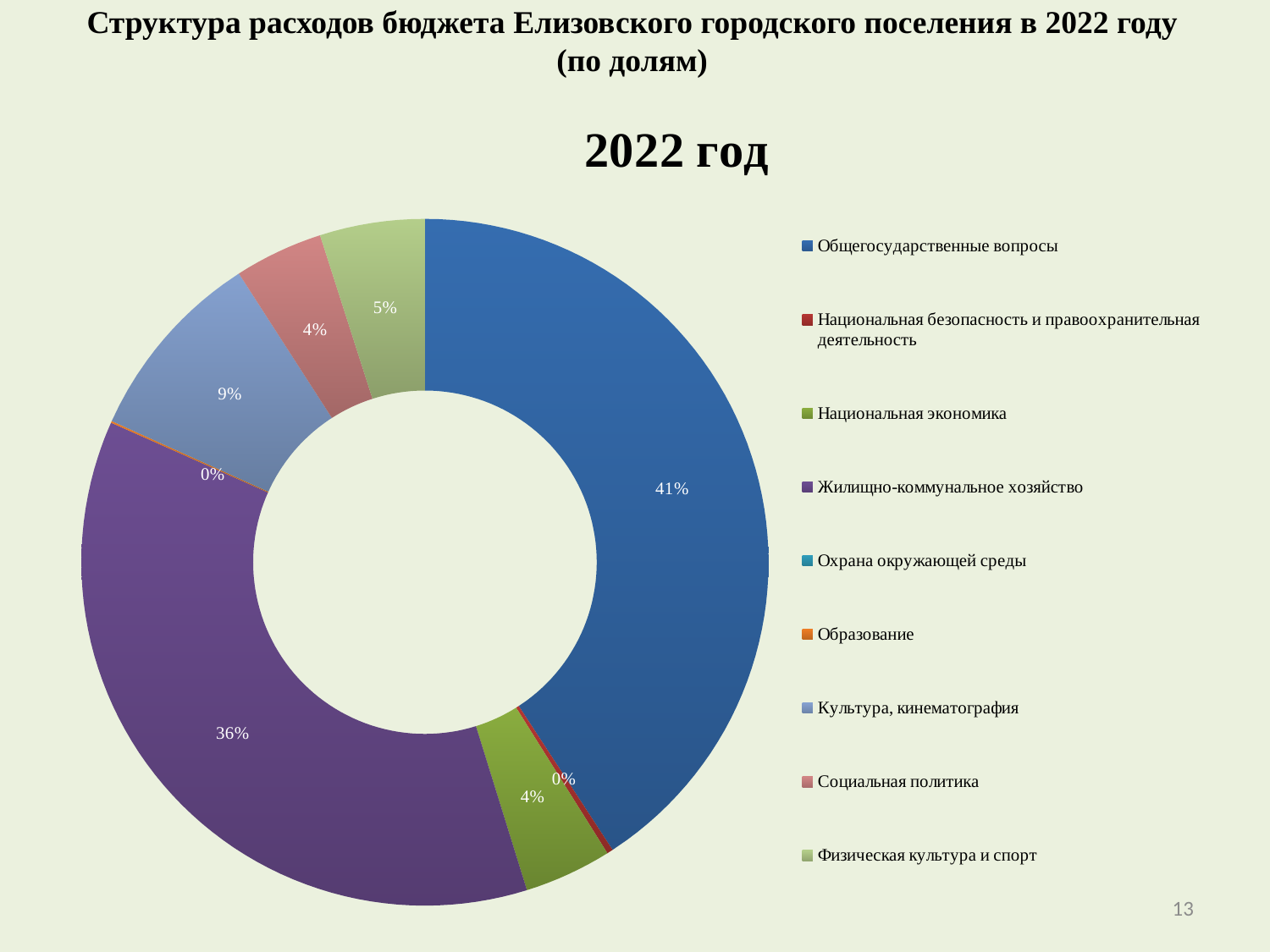
What share is labelled for Национальная экономика? 4% What type of chart is shown on the slide? Pie (doughnut) chart By how many percentage points is the share of Культура, кинематография larger than that of Физическая культура и спорт? 4 percentage points What percentage is shown for Социальная политика? 4% What share is shown for Жилищно-коммунальное хозяйство? 36% By how many percentage points does the share of Общегосударственные вопросы exceed that of Жилищно-коммунальное хозяйство? 5 percentage points What share does Физическая культура и спорт have in the chart? 5% Which category has the largest share of expenditure in the chart? Общегосударственные вопросы How many categories are listed in the chart legend? 9 What share of the 2022 budget expenditure goes to Общегосударственные вопросы? 41% What percentage is labelled for Культура, кинематография? 9% Which is larger: the share for Жилищно-коммунальное хозяйство or for Общегосударственные вопросы? Общегосударственные вопросы